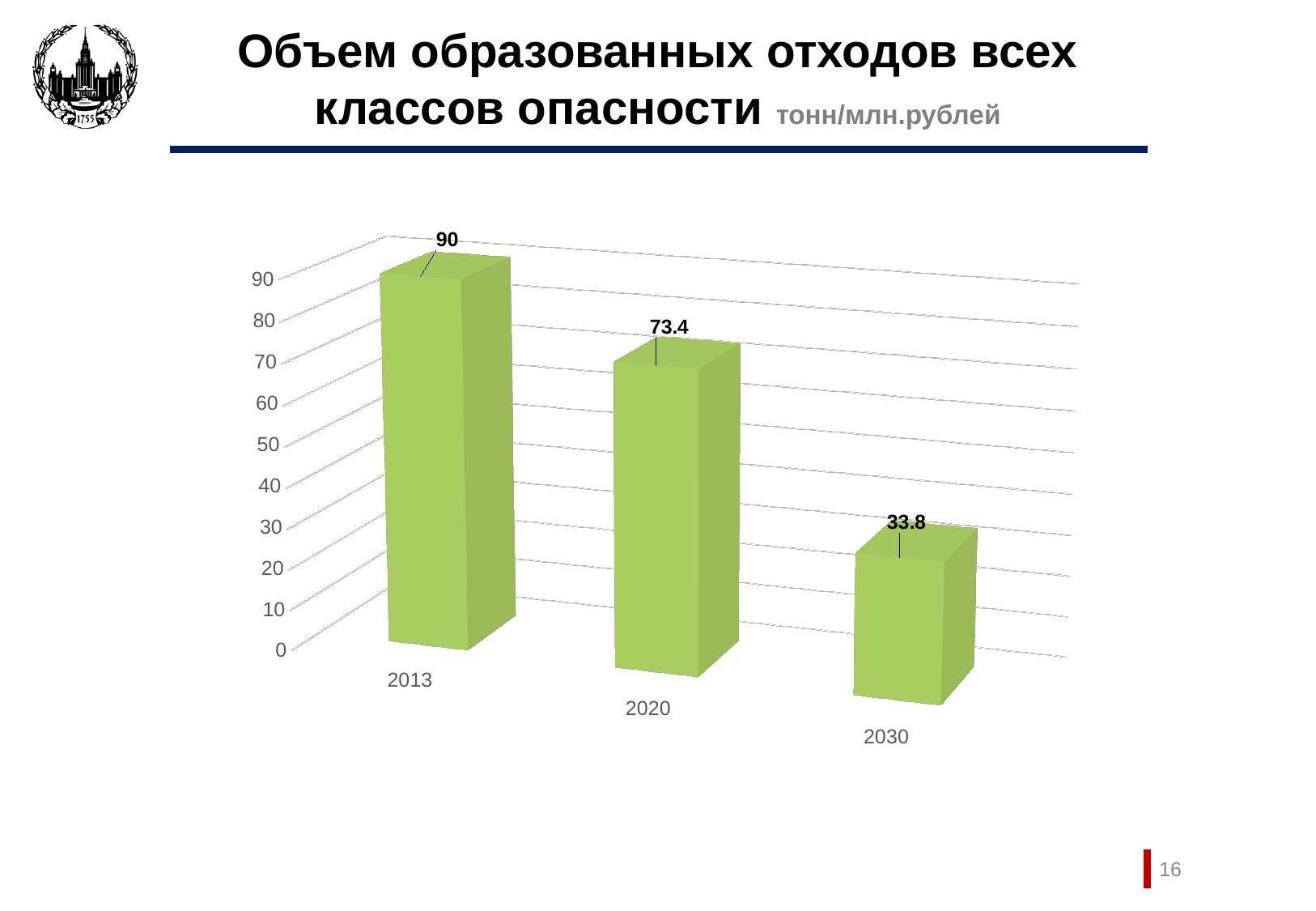
What kind of chart is shown on the slide? bar chart What is the difference between the values for 2013 and 2020? 16.6 What is the value for 2013? 90 What is the value for 2020? 73.4 Which year has the highest value? 2013 Is the value for 2030 greater or less than 40? less Which year has the lowest value? 2030 What is the difference between the values for 2020 and 2030? 39.6 Do the values rise or fall from 2013 to 2030? fall How many years are shown on the x axis? 3 Which is larger, the value for 2020 or the value for 2030? 2020 What is the value for 2030? 33.8